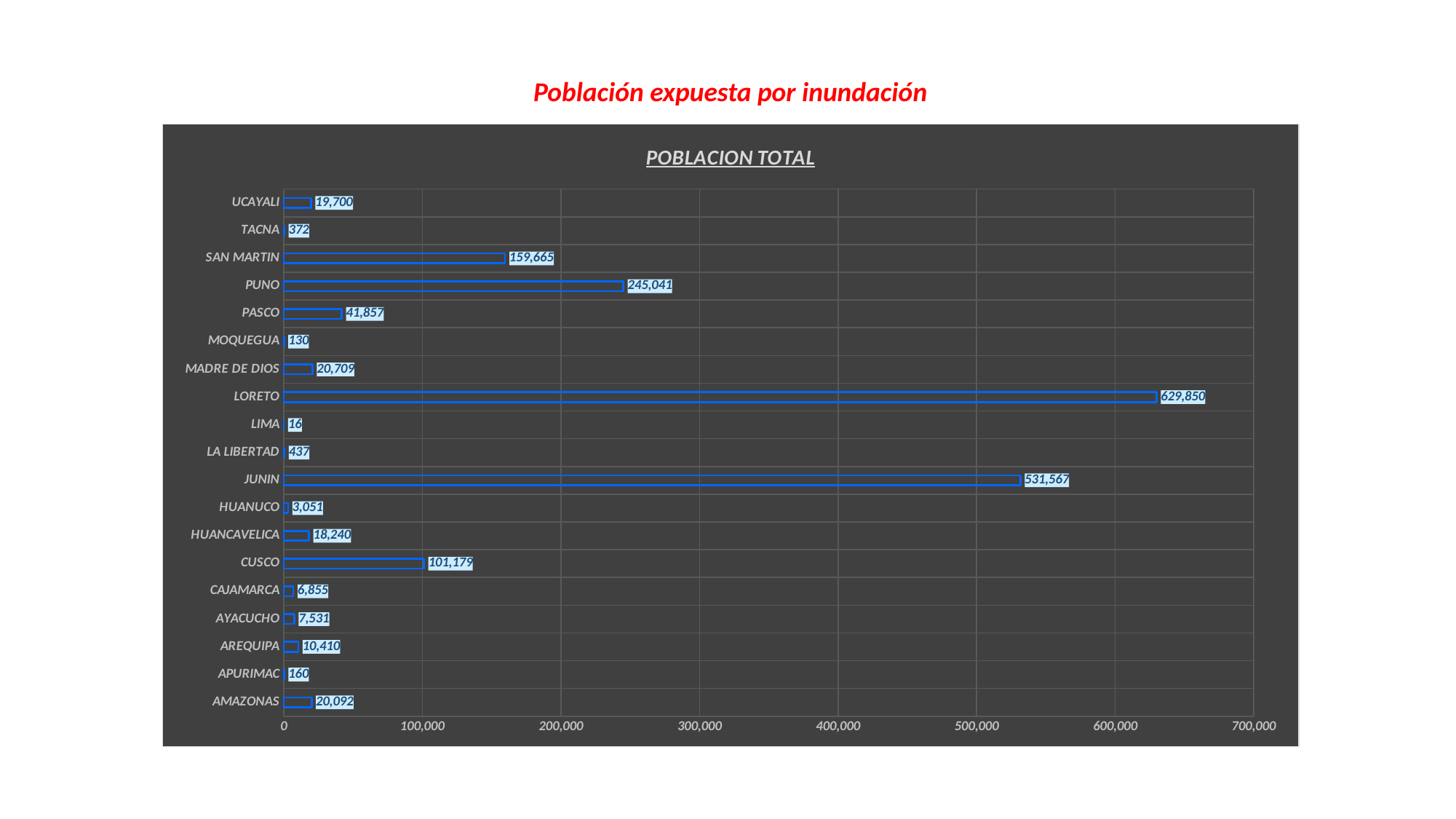
How many categories are shown on the chart? 19 What is the value for HUANCAVELICA? 18,240 Which is larger, the value for CUSCO or the value for PASCO? CUSCO What kind of chart is shown on the slide? bar chart Is the value for JUNIN greater or less than 500,000? greater What is the title of the chart? POBLACION TOTAL What is the value for PUNO? 245,041 What is the difference between the values for LORETO and JUNIN? 98,283 What is the difference between the values for PUNO and SAN MARTIN? 85,376 What is the value for LORETO? 629,850 Which category has the highest value? LORETO Which category has the lowest value? LIMA